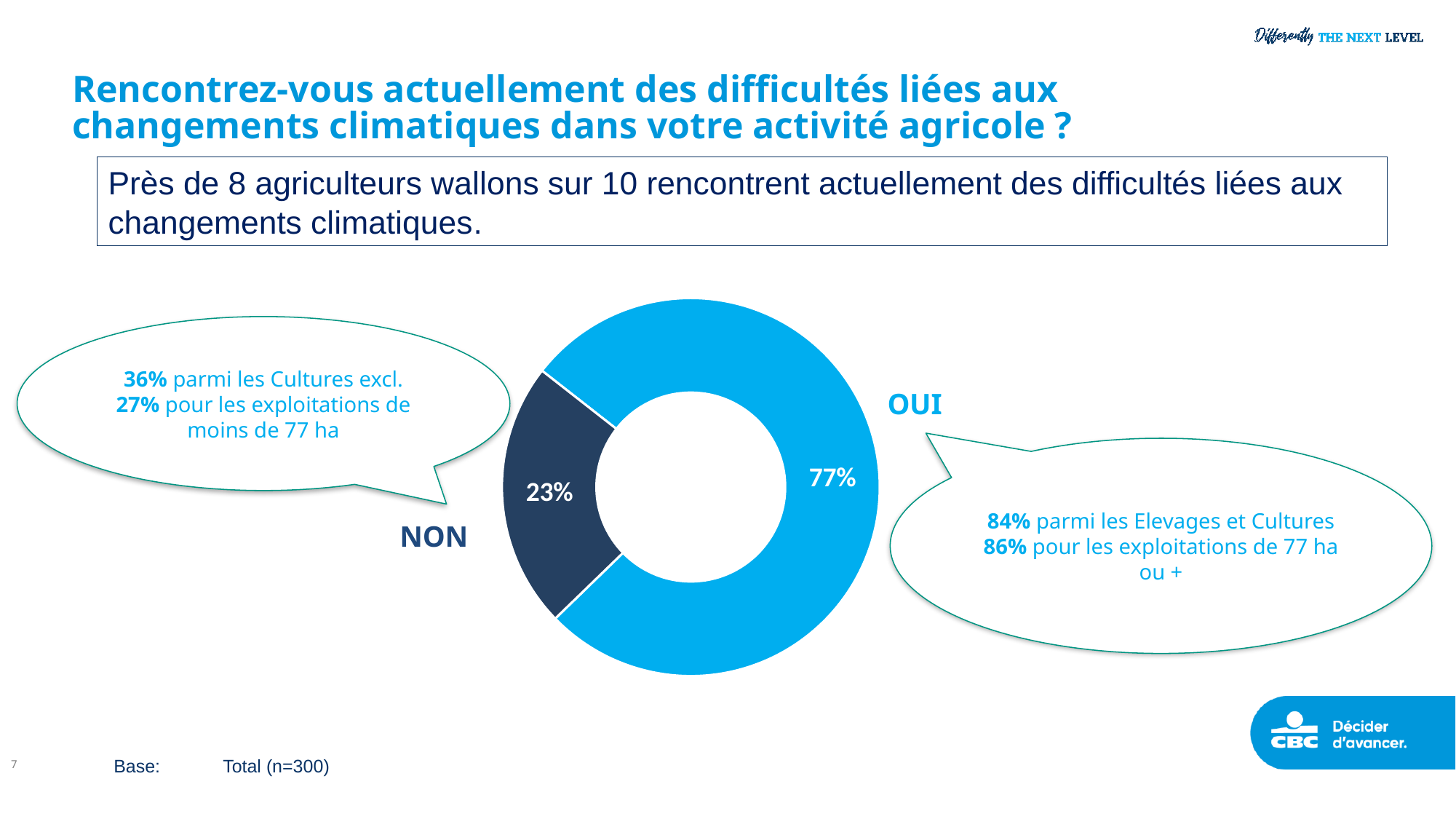
What kind of chart is shown on the slide? Pie chart (doughnut) What percentage of respondents answered OUI? 77% Which category has the smallest share of the chart? NON How many categories are shown in the chart? 2 What is the base (sample size) stated for the chart? Total (n=300) Which is larger, the share for OUI or the share for NON? OUI What percentage of respondents answered NON? 23% What is the difference in percentage points between OUI and NON? 54 What is the total of the two slices shown in the chart? 100% What colour is the OUI slice of the chart? Light blue Which category has the largest share of the chart? OUI